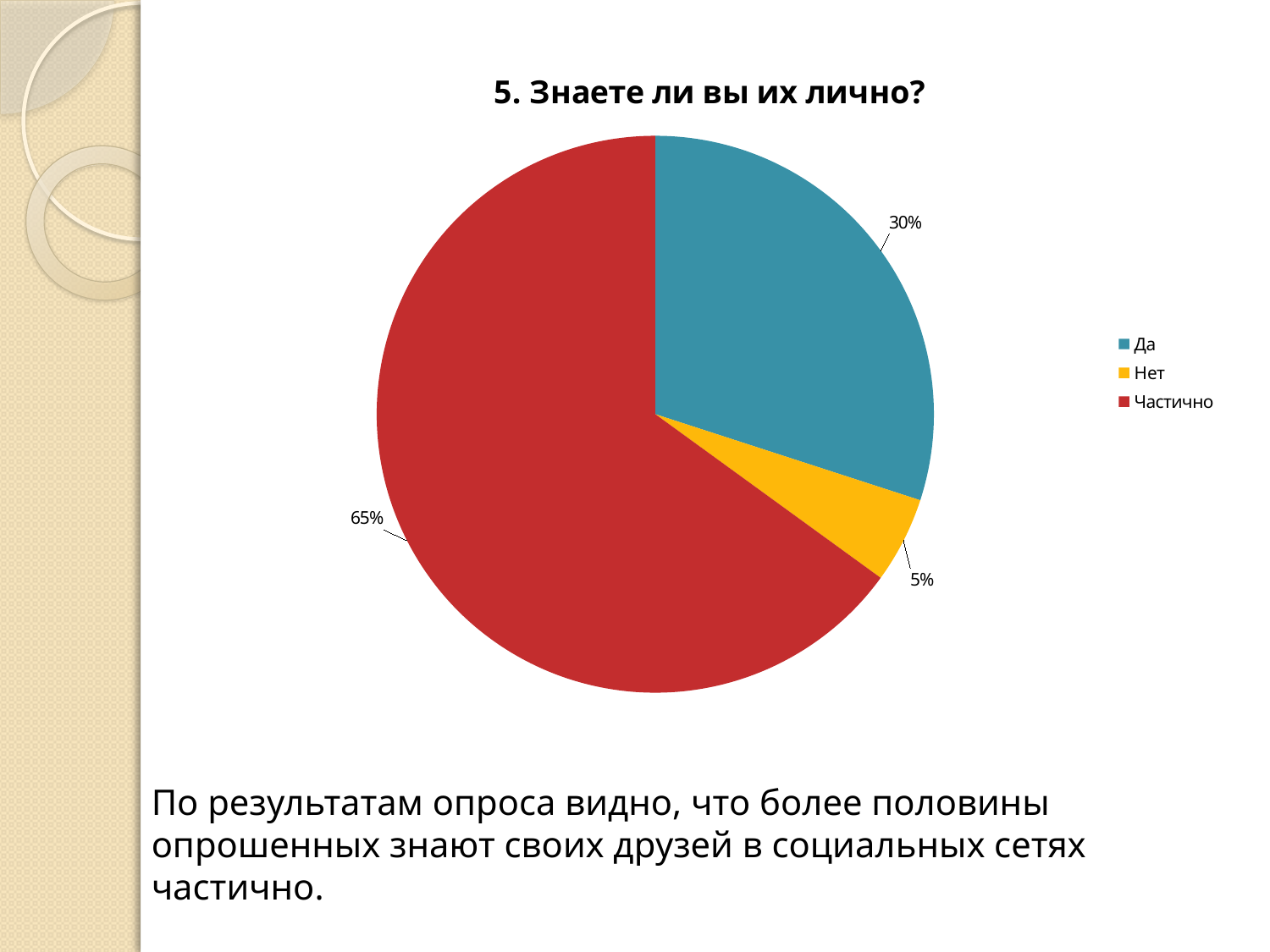
What percentage of respondents answered "Да"? 30% What percentage of respondents answered "Нет"? 5% What percentage of respondents answered "Частично"? 65% What colour is the slice for "Частично"? red Which answer has the largest share of the pie? Частично Which is larger, the share for "Да" or the share for "Нет"? Да What type of chart is shown on the slide? pie chart Which answer has the smallest share of the pie? Нет What is the title of the chart? 5. Знаете ли вы их лично? How many entries does the legend list? 3 What is the difference in percentage points between "Частично" and "Да"? 35 How many slices does the pie chart have? 3